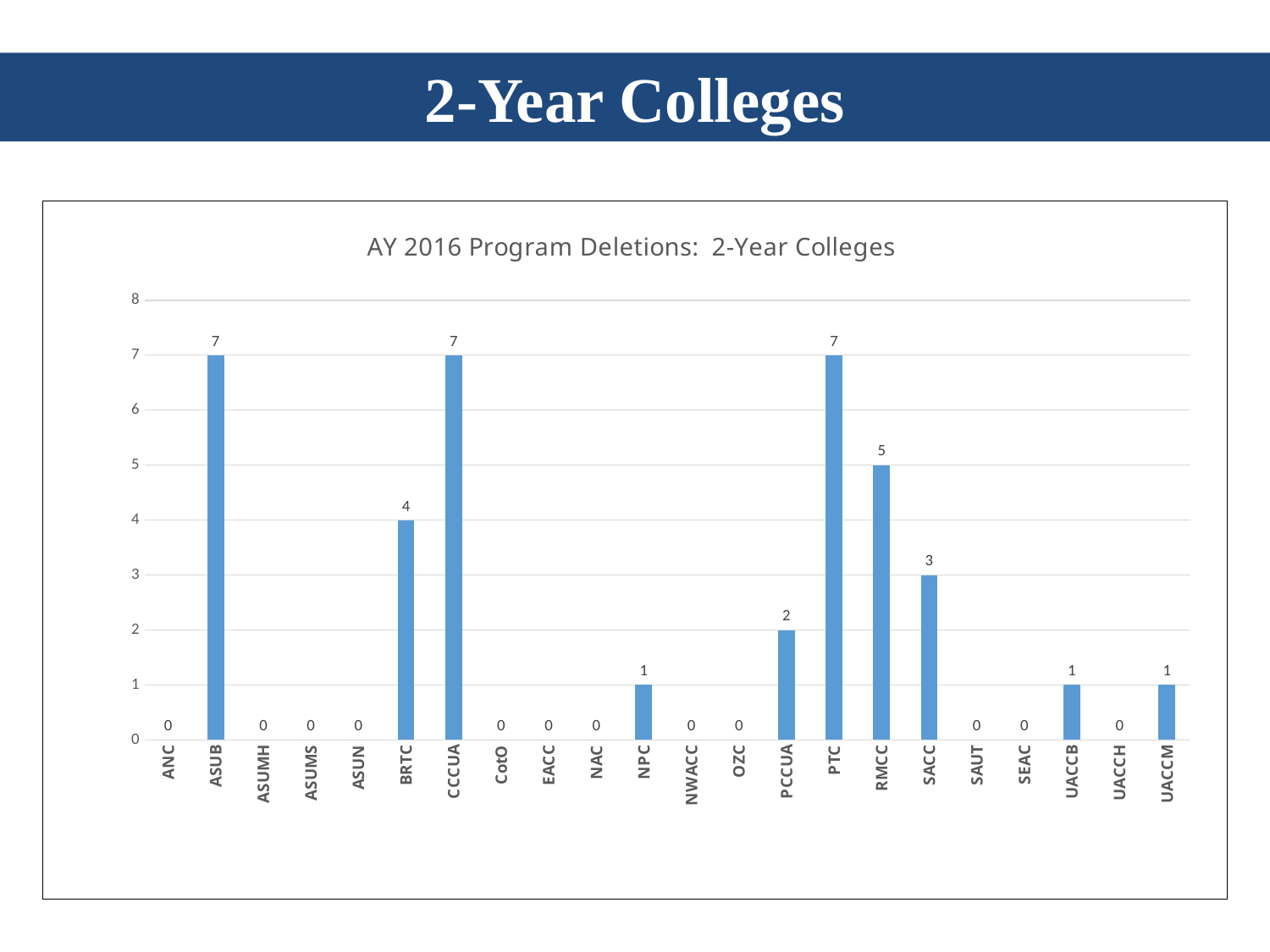
What is the difference between the values for PTC and RMCC? 2 What is the value for BRTC? 4 What is the highest value shown on the chart? 7 How many categories are shown on the x axis? 22 What is the value for NWACC? 0 What is the value for RMCC? 5 What is the difference between the values for BRTC and UACCB? 3 Which is larger, the value for SACC or the value for PCCUA? SACC What is the value for PCCUA? 2 What is the title of the chart? AY 2016 Program Deletions: 2-Year Colleges What kind of chart is this? bar chart What is the value for SACC? 3